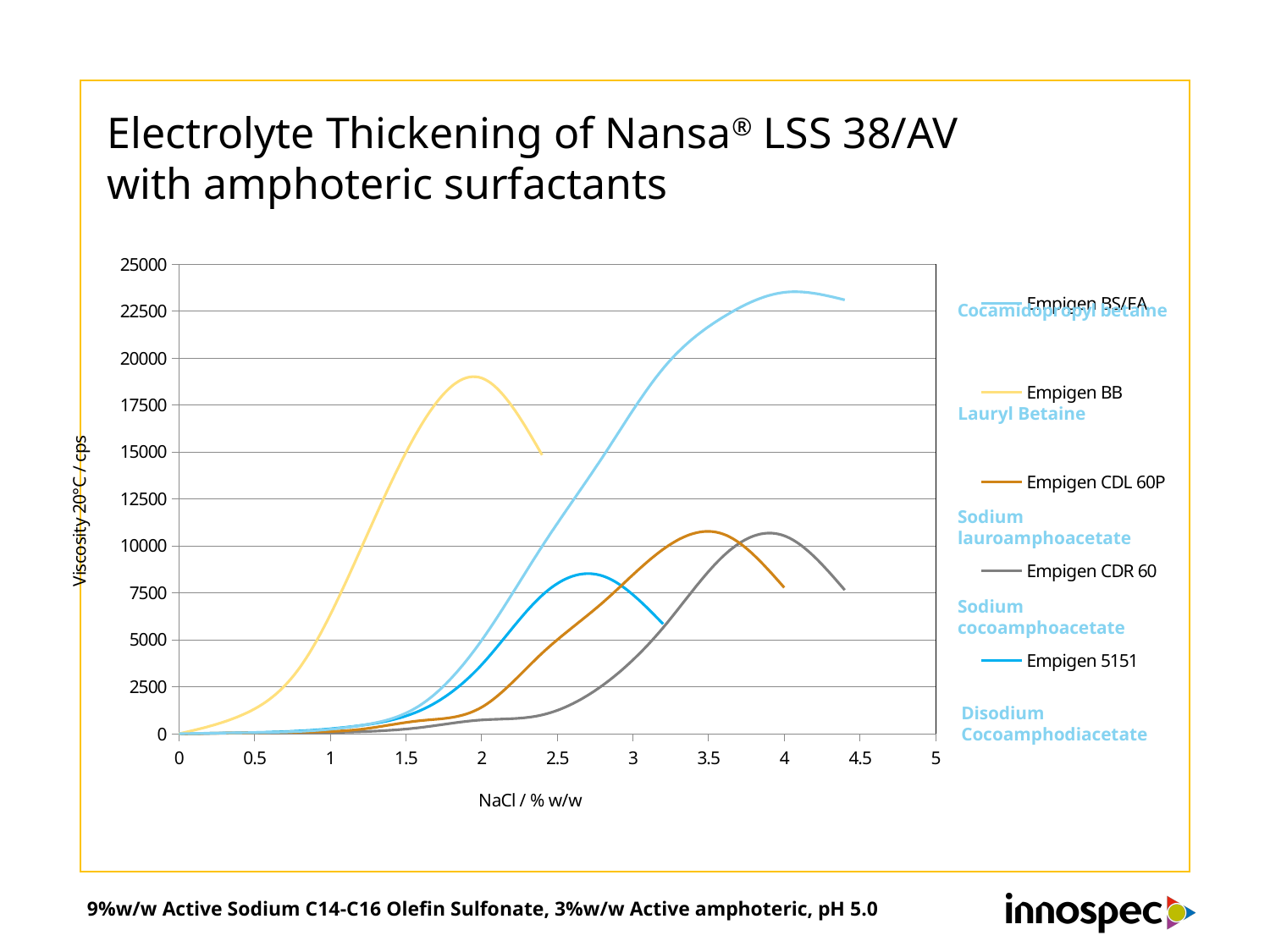
Does the viscosity of Empigen BB rise or fall as NaCl increases from 0 to 1.5% w/w? rise Is the peak viscosity of Empigen BB greater or less than 17500? greater How many series does the chart legend list? 5 What is the label on the x axis of the chart? NaCl / % w/w What is the label on the y axis of the chart? Viscosity 20°C / cps Is the peak viscosity of Empigen 5151 greater or less than 10000? less Which series has the lowest peak viscosity on the chart? Empigen 5151 What kind of chart is shown on the slide? line chart Which series reaches a higher peak viscosity, Empigen BB or Empigen CDL 60P? Empigen BB Is the peak viscosity of Empigen BS/FA greater or less than 22500? greater Which series reaches the highest viscosity on the chart? Empigen BS/FA